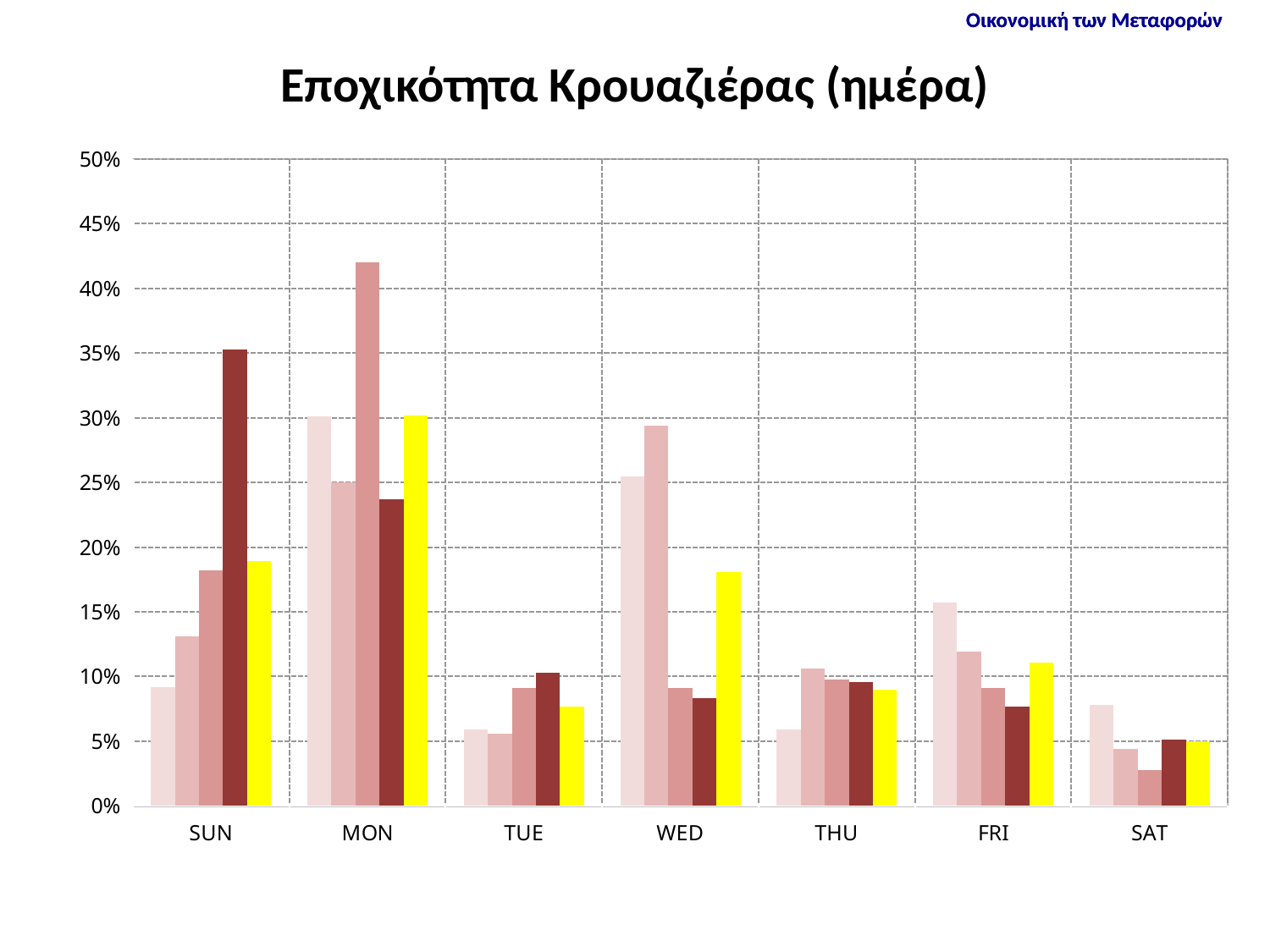
Is the value of the dark red bar for SUN greater or less than 30%? greater Is the value of the yellow bar for TUE greater or less than 10%? less What kind of chart is shown on the slide? bar chart For which day is the yellow bar the lowest? SAT How many bars are plotted for each day category? 5 Which is larger: the dark red bar for SUN or the dark red bar for MON? SUN Is the value of the tallest bar for MON greater or less than 40%? greater How many day categories are shown on the x axis? 7 What is the title of the chart? Εποχικότητα Κρουαζιέρας (ημέρα) For which day is the yellow bar the highest? MON Which is larger: the yellow bar for WED or the yellow bar for THU? WED